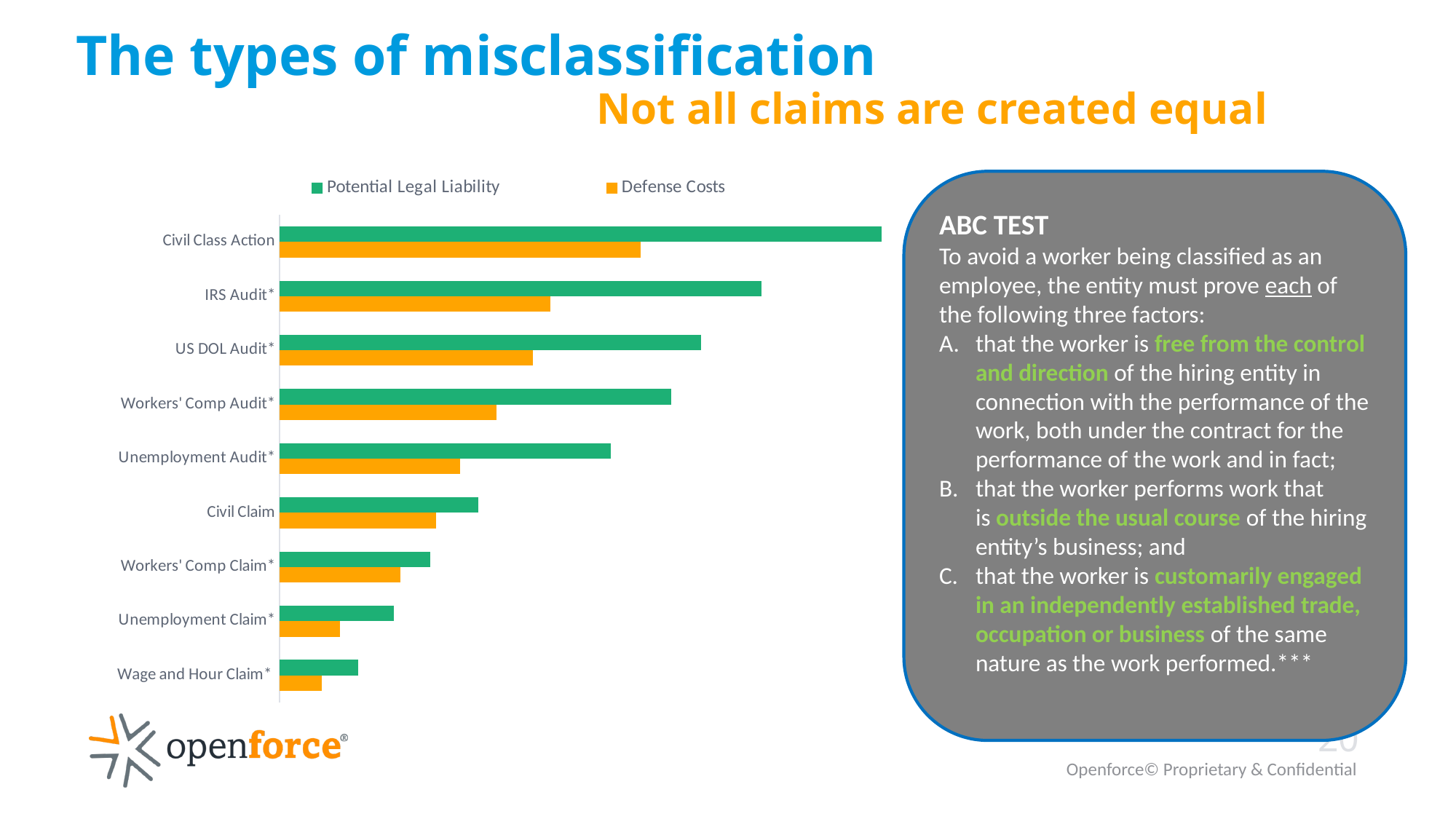
What kind of chart is shown on the slide? Bar chart How many categories are plotted on the chart? 9 Which category has the highest Potential Legal Liability? Civil Class Action Which has the larger Defense Costs, Workers' Comp Claim* or Unemployment Claim*? Workers' Comp Claim* How many series does the chart legend list? 2 What colour are the Defense Costs bars? Orange Which category has the lowest Defense Costs? Wage and Hour Claim* Which category has the lowest Potential Legal Liability? Wage and Hour Claim* Which has the larger Potential Legal Liability, Civil Class Action or IRS Audit*? Civil Class Action Which category has the highest Defense Costs? Civil Class Action Do the Potential Legal Liability bars get longer or shorter going from the top category to the bottom category? Shorter For Civil Claim, which is larger, Potential Legal Liability or Defense Costs? Potential Legal Liability